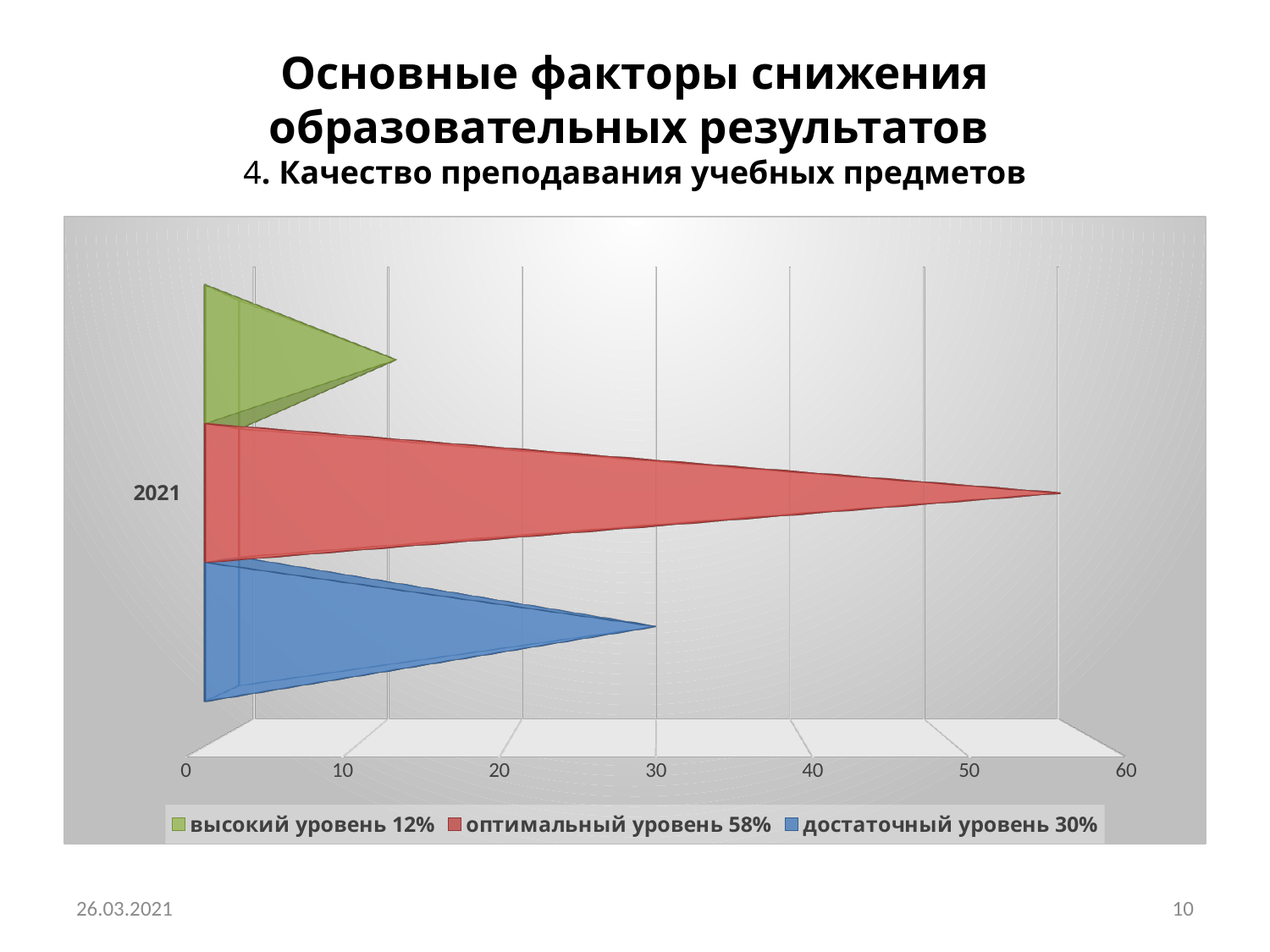
Which is larger: достаточный уровень or высокий уровень? достаточный уровень Is the value for высокий уровень greater or less than 20? less What percentage is given in the legend for оптимальный уровень? 58% What kind of chart is shown on the slide? bar chart What colour is used for the оптимальный уровень series? red How many categories are shown on the vertical axis of the chart? 1 How many series does the chart legend list? 3 What percentage is given in the legend for высокий уровень? 12% What percentage is given in the legend for достаточный уровень? 30% Is the value for оптимальный уровень greater or less than 50? greater Which series has the lowest value in the chart? высокий уровень Which series has the highest value in the chart? оптимальный уровень